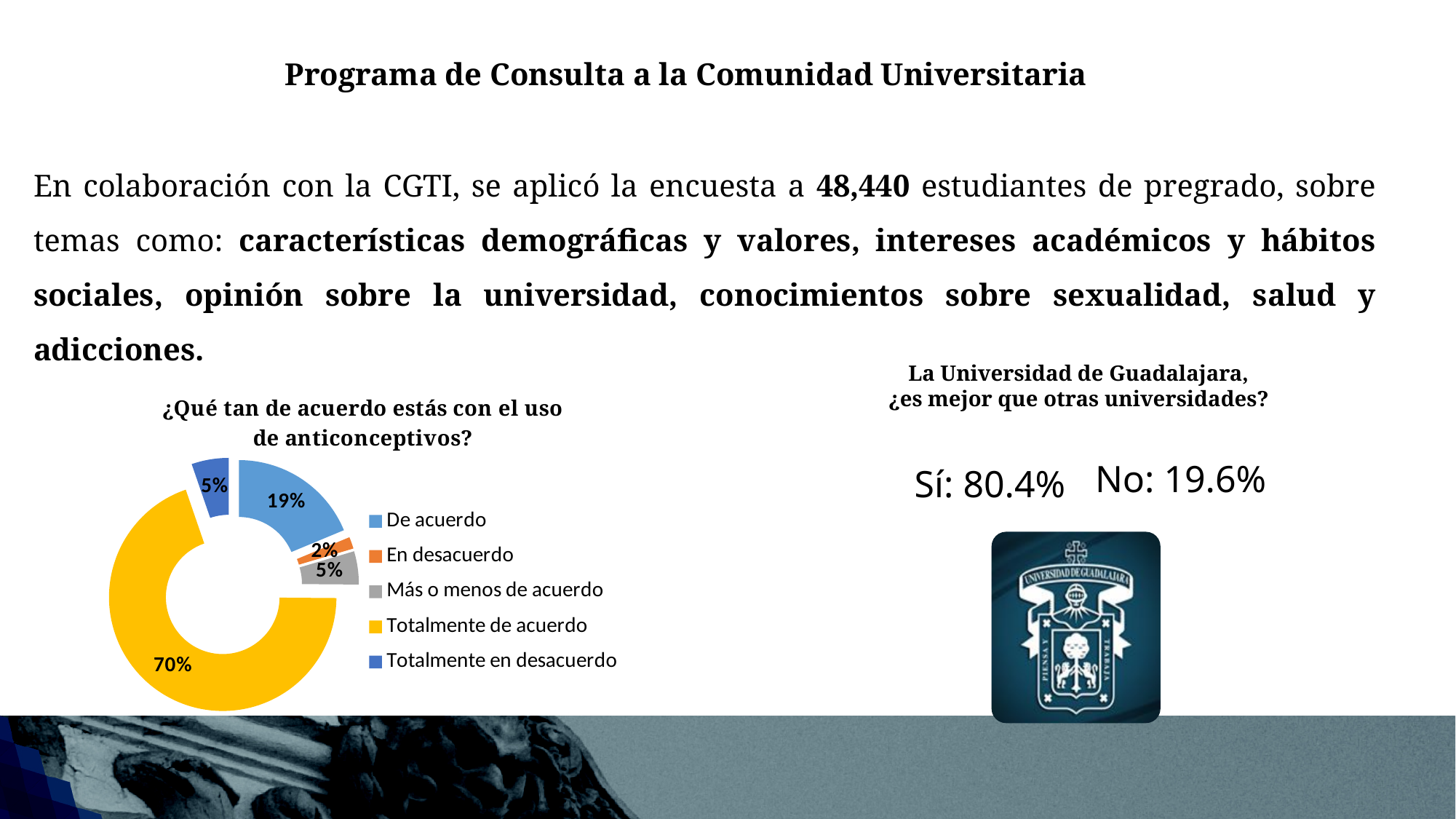
In the doughnut chart, what percentage of respondents answered "De acuerdo"? 19% What is the title of the doughnut chart? ¿Qué tan de acuerdo estás con el uso de anticonceptivos? How many response categories does the doughnut chart's legend list? 5 What kind of chart is used to show the responses about the use of contraceptives? Doughnut (pie) chart In the doughnut chart, how many percentage points larger is "Totalmente de acuerdo" than "De acuerdo"? 51 percentage points What colour represents "Totalmente de acuerdo" in the doughnut chart? Yellow In the doughnut chart, what percentage of respondents answered "En desacuerdo"? 2% Which response category has the smallest share in the doughnut chart? En desacuerdo Which response category has the largest share in the doughnut chart? Totalmente de acuerdo In the doughnut chart, which is larger: "De acuerdo" or "Más o menos de acuerdo"? De acuerdo In the doughnut chart, what percentage of respondents answered "Totalmente de acuerdo"? 70% In the doughnut chart, what percentage of respondents answered "Más o menos de acuerdo"? 5%